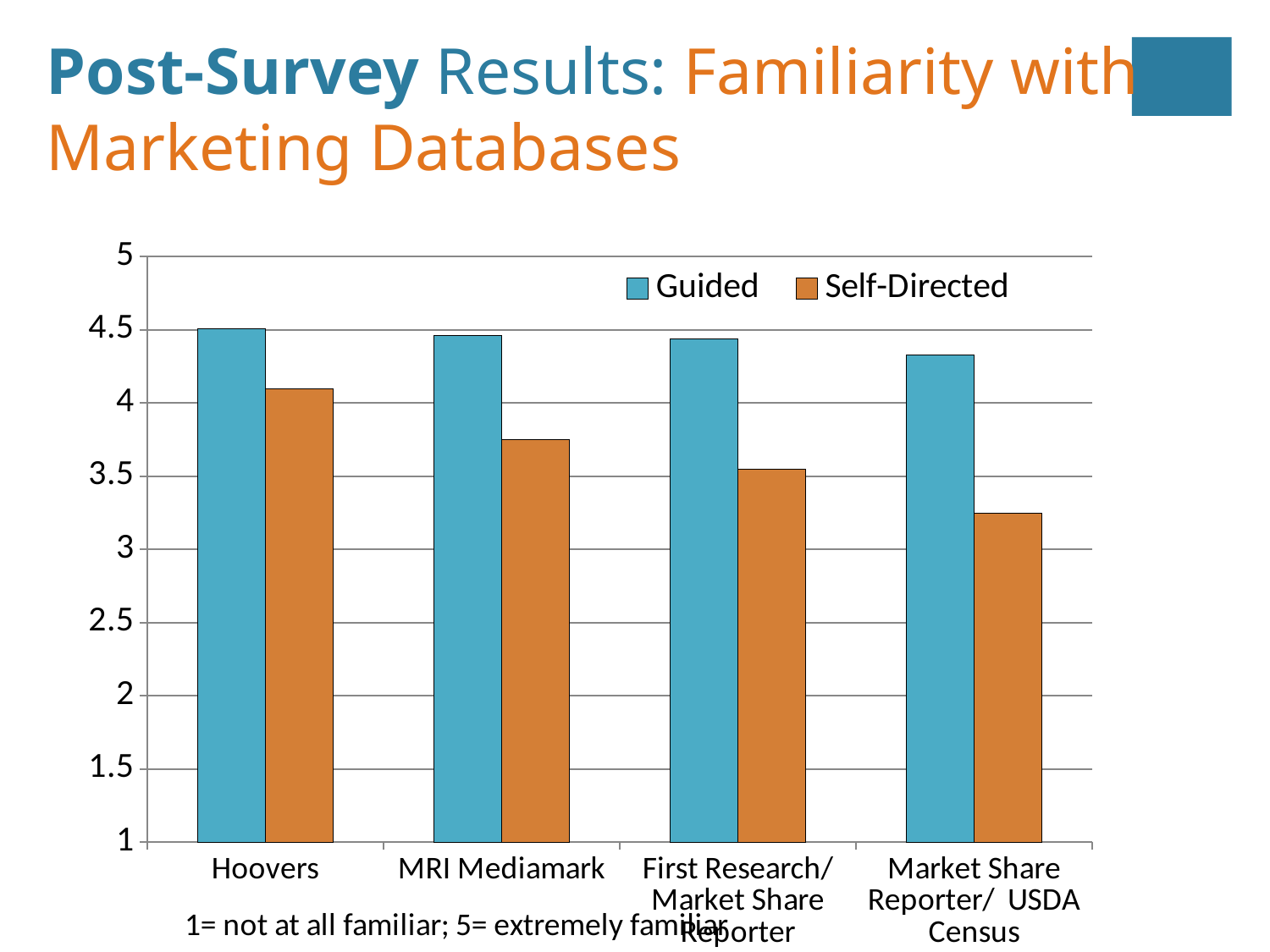
What kind of chart is shown on the slide? bar chart Which category has the lowest Self-Directed value? Market Share Reporter/ USDA Census Is the Self-Directed value for Market Share Reporter/ USDA Census greater or less than 3.5? less Is the Self-Directed value for First Research/ Market Share Reporter greater or less than 4? less Is the Guided value for Market Share Reporter/ USDA Census greater or less than 4? greater How many database categories are shown on the x axis? 4 Which category has the highest Self-Directed value? Hoovers What are the two series named in the legend? Guided and Self-Directed How many series does the legend list? 2 Do the Self-Directed values rise or fall moving left to right across the categories? fall For MRI Mediamark, which is larger: the Guided value or the Self-Directed value? Guided